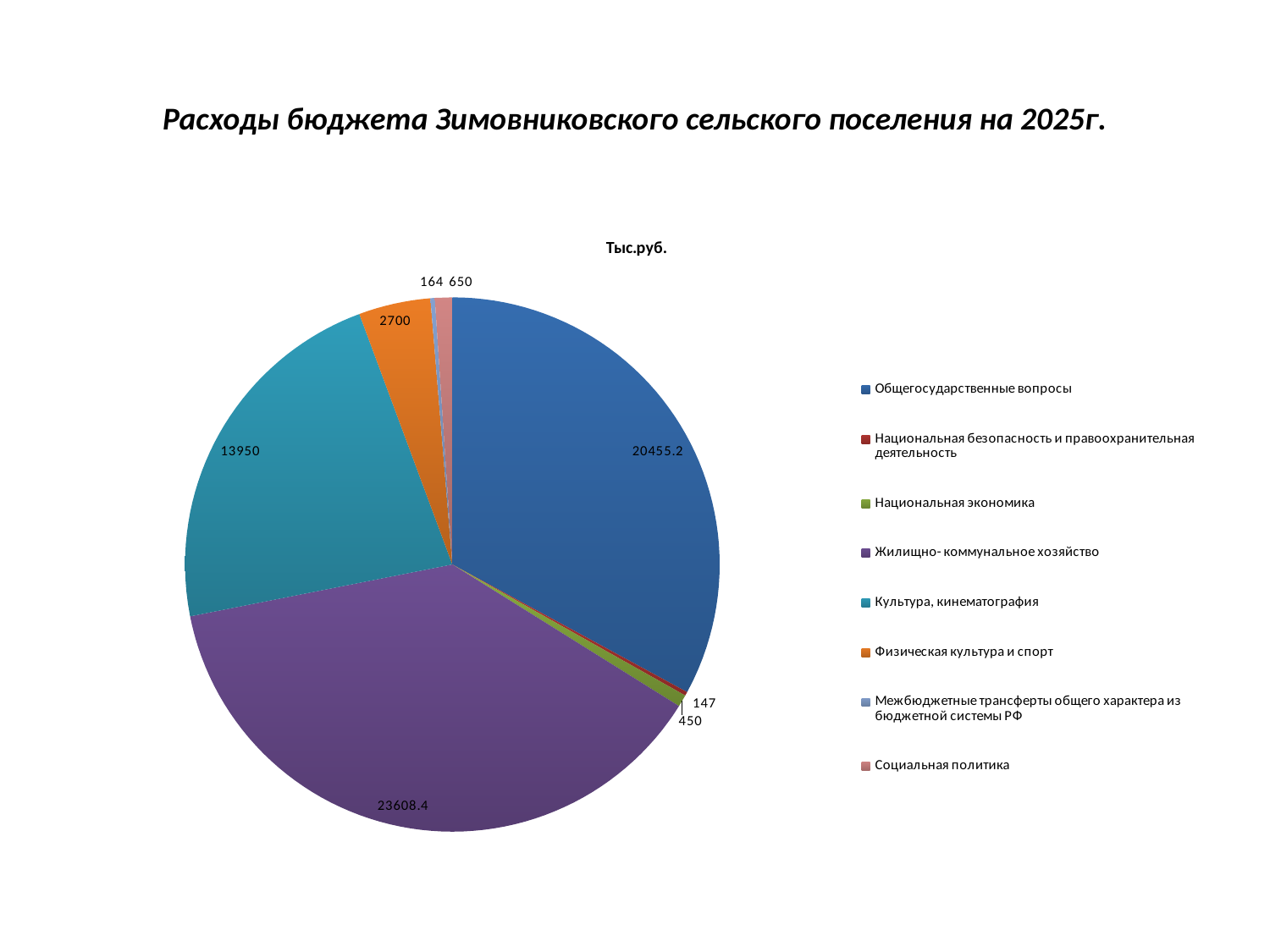
What is the value for Социальная политика? 650 What is the value for Жилищно- коммунальное хозяйство? 23608.4 What is the title shown above the pie chart? Тыс.руб. How many categories does the legend list? 8 What is the value for Культура, кинематография? 13950 What is the value for Физическая культура и спорт? 2700 What type of chart is shown on the slide? pie chart Which category has the smallest slice of the pie? Национальная безопасность и правоохранительная деятельность Which category has the largest slice of the pie? Жилищно- коммунальное хозяйство Which is larger, the value for Национальная экономика or the value for Межбюджетные трансферты общего характера из бюджетной системы РФ? Национальная экономика What is the difference between the values for Жилищно- коммунальное хозяйство and Общегосударственные вопросы? 3153.2 What is the value for Общегосударственные вопросы? 20455.2